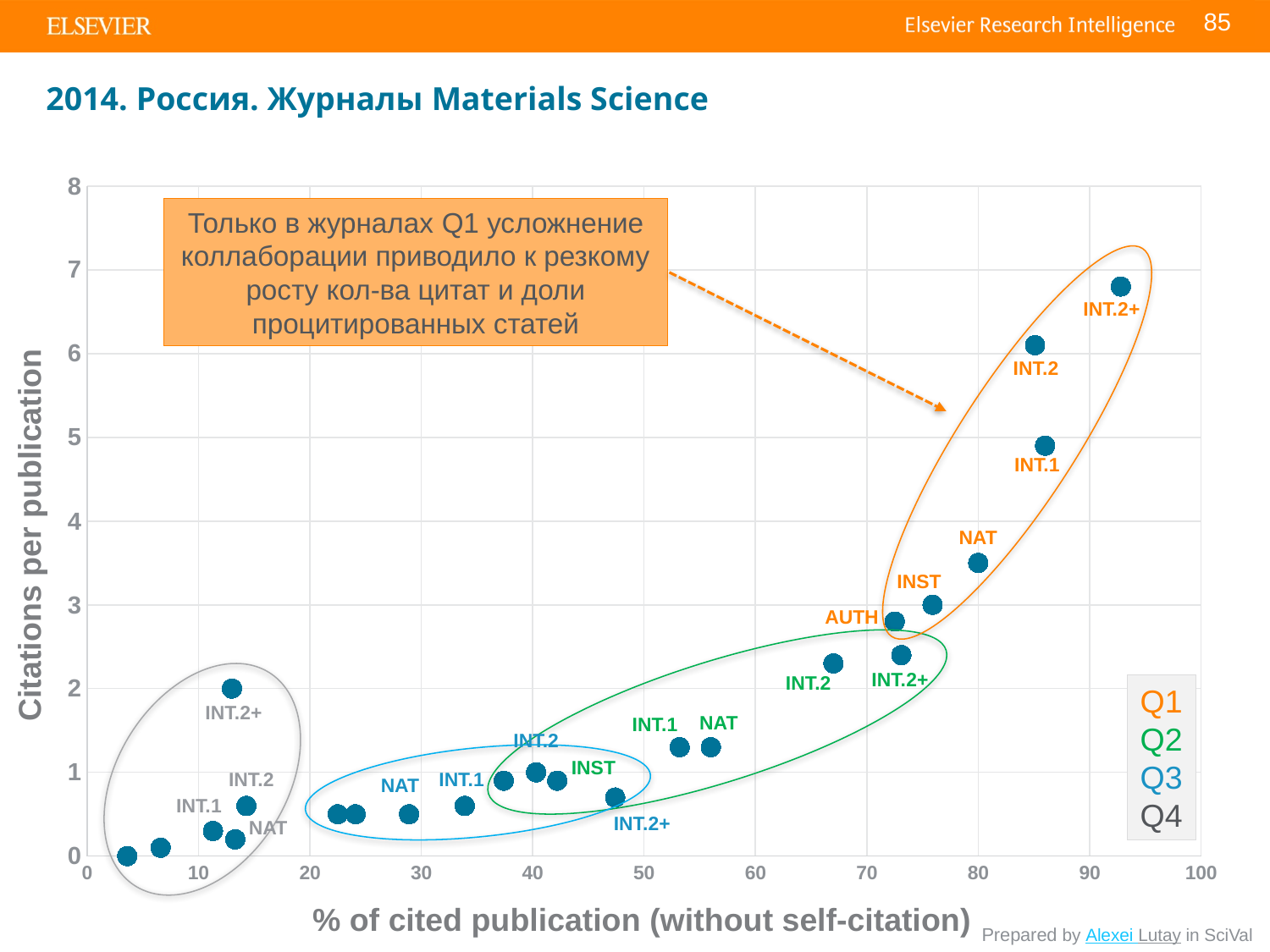
Is the citations per publication value for the Q1 INT.2+ point greater or less than 6? greater How many entries does the legend list? 4 Which point in the Q1 group has the highest citations per publication? INT.2+ What kind of chart is shown on the slide? Scatter chart What is the title of the chart? 2014. Россия. Журналы Materials Science Which has more citations per publication, the Q1 INT.2 point or the Q1 INT.1 point? INT.2 Is the citations per publication value for the Q1 NAT point greater or less than 4? less Is the citations per publication value for the Q1 INT.1 point greater or less than 4? greater Overall, do citations per publication rise or fall as % of cited publication increases? rise What is the label of the y axis? Citations per publication